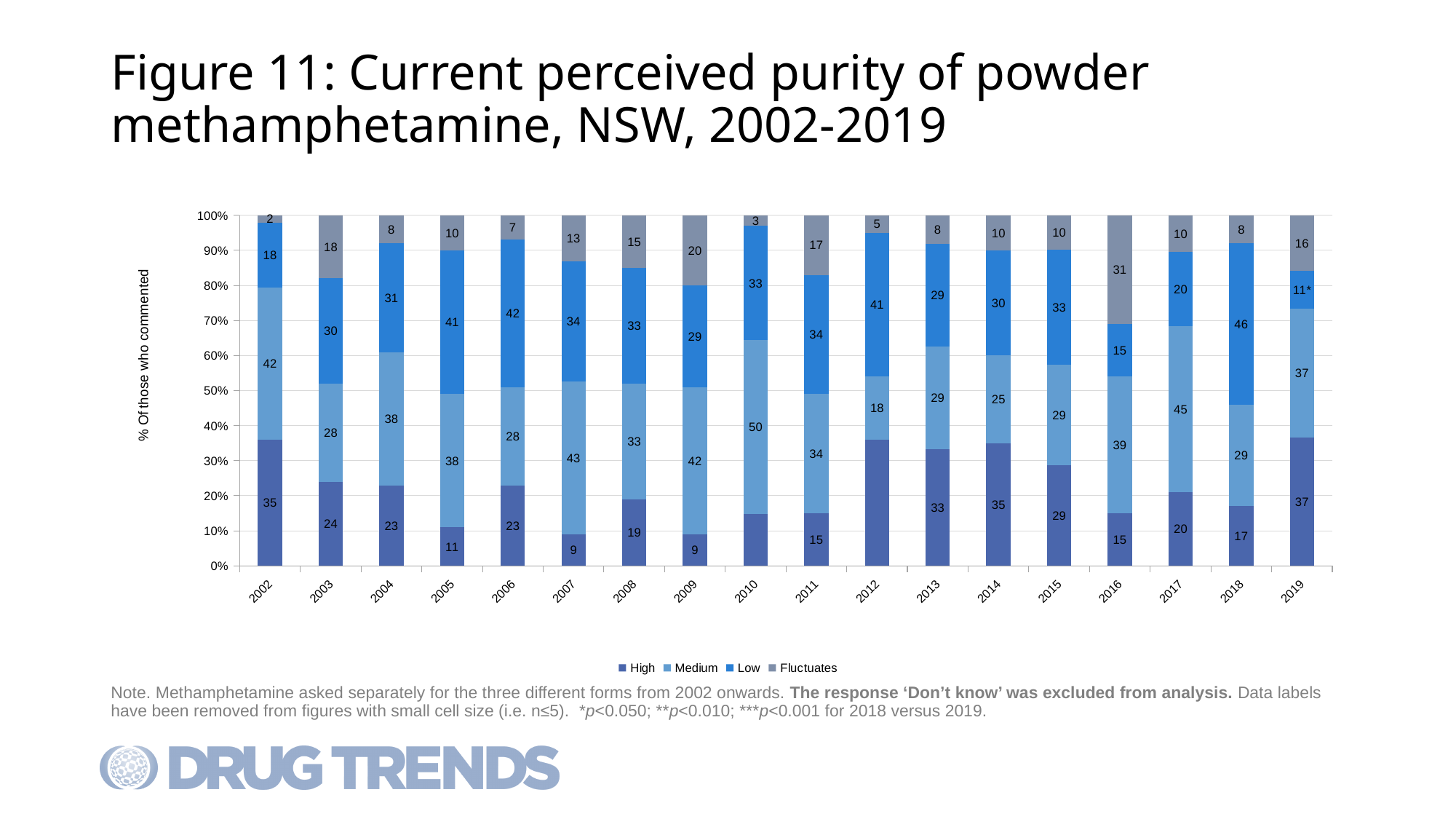
In which year is the Fluctuates value lowest? 2002 Which is larger, the Low value in 2006 or the Low value in 2007? 2006 What is the difference between the Medium value in 2017 and the Medium value in 2018? 16 What kind of chart is shown on the slide? Stacked bar chart In which year is the Medium value highest? 2010 How many years are shown on the x axis? 18 How many series does the legend list? 4 Is the High segment for 2012 greater or less than 30%? greater What is the value for Medium in 2017? 45 What is the value for High in 2002? 35 What is the value for Fluctuates in 2016? 31 What is the value for Low in 2018? 46